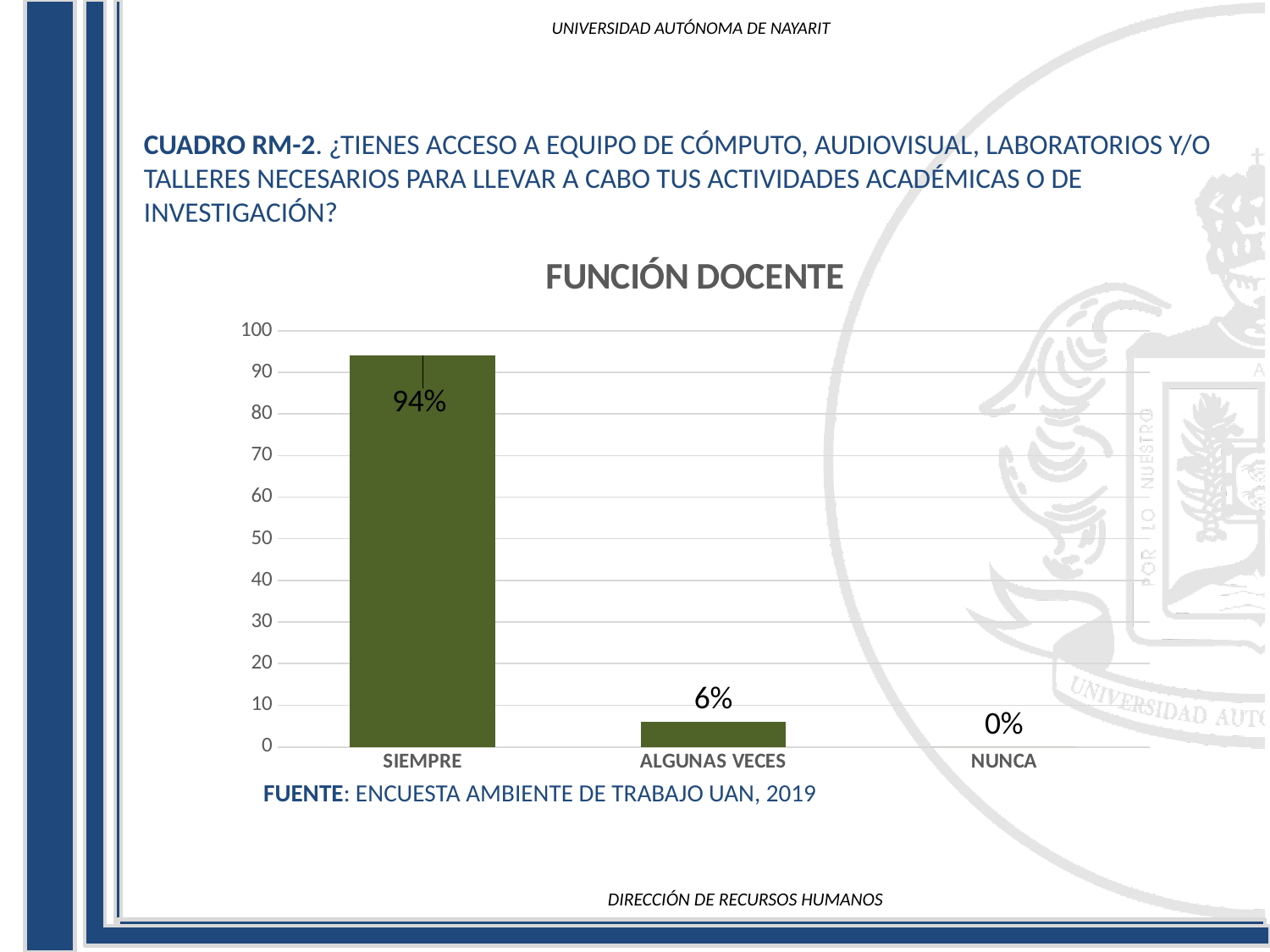
Do the values rise or fall from left to right along the x axis? fall What is the difference between the values for SIEMPRE and ALGUNAS VECES? 88% What is the value for ALGUNAS VECES? 6% Which category has the lowest value? NUNCA Is the value for SIEMPRE greater or less than 90? greater How many categories are shown on the x axis? 3 What is the title of the chart? FUNCIÓN DOCENTE What kind of chart is shown on the slide? bar chart What is the value for NUNCA? 0% Which category has the highest value? SIEMPRE What is the value for SIEMPRE? 94% Which is larger, the value for ALGUNAS VECES or the value for NUNCA? ALGUNAS VECES